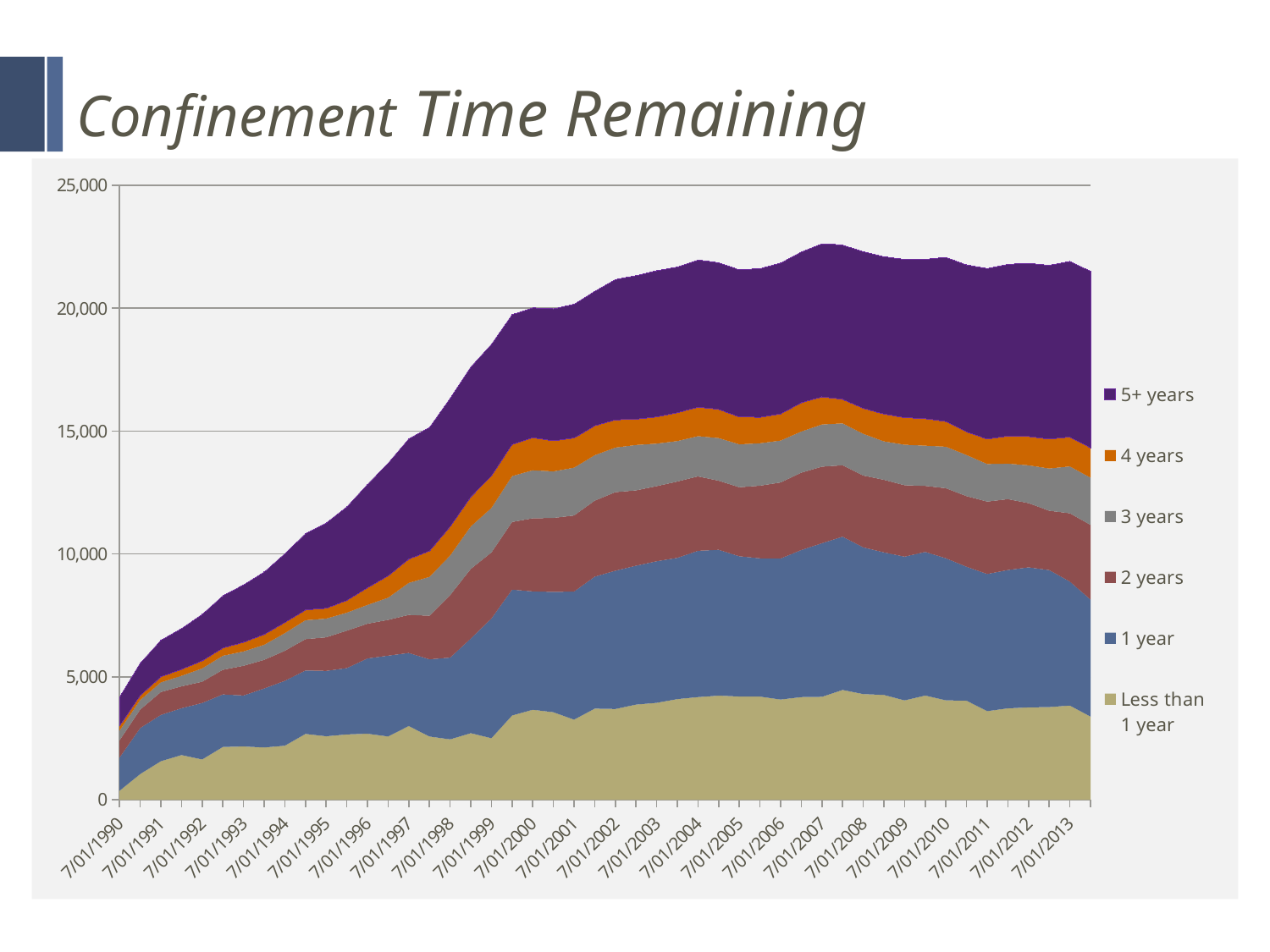
Does the total stacked value rise or fall between 7/01/1990 and 7/01/2007? rise How many dates are labeled on the x axis? 24 Is the total stacked value at 7/01/1995 greater or less than 10,000? greater How many series does the legend list? 6 Which series is listed first (at the top) in the legend? 5+ years What is the title of the chart? Confinement Time Remaining Which series has the largest value at 7/01/2013? 5+ years What kind of chart is shown on the slide? Area chart Is the total stacked value at 7/01/2007 greater or less than 25,000? less Is the total stacked value at 7/01/1990 greater or less than 5,000? less Which is larger, the total stacked value at 7/01/2007 or at 7/01/1990? 7/01/2007